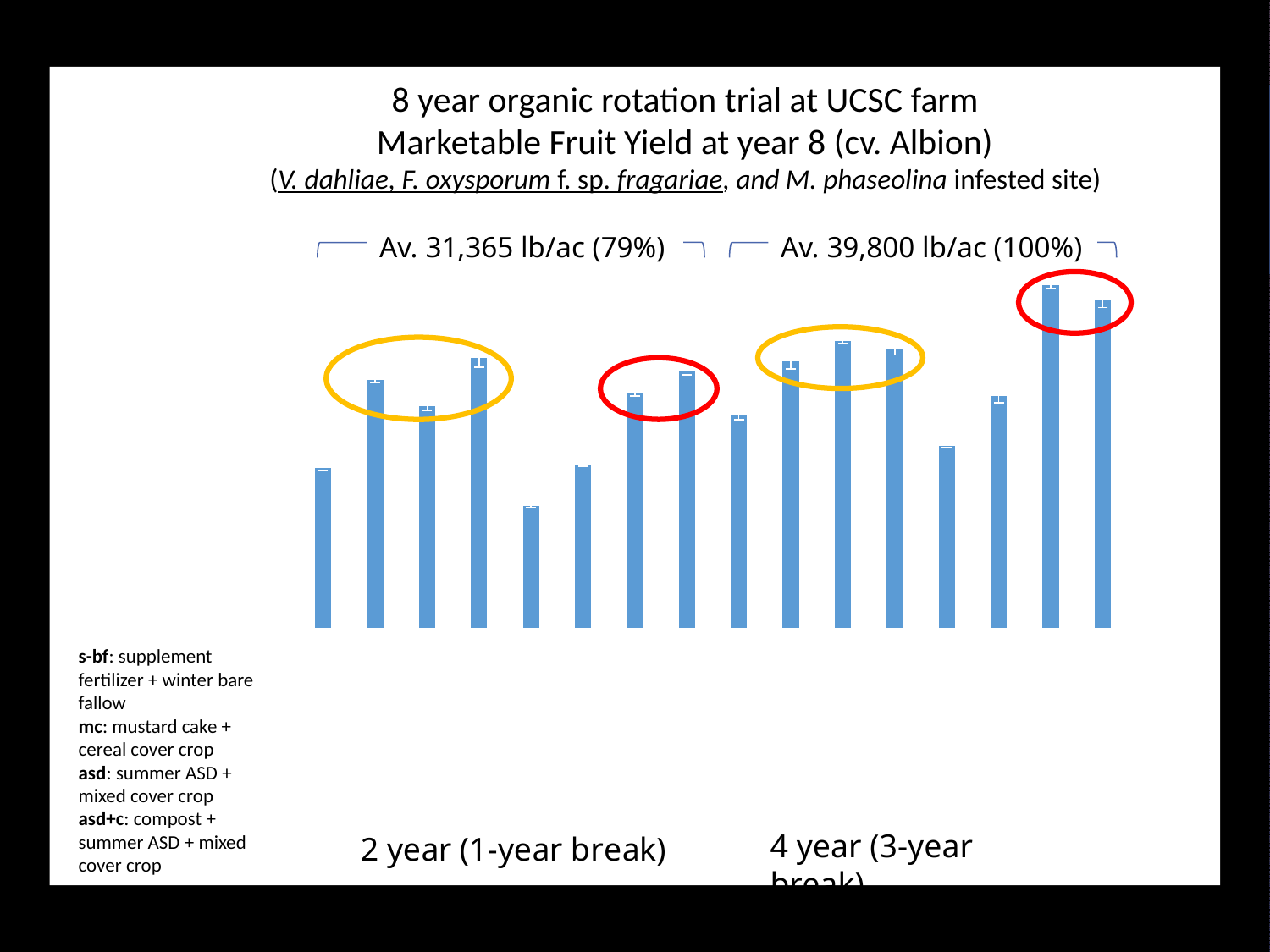
What kind of chart is shown on the slide? bar chart What average yield is annotated above the 2 year (1-year break) group of bars? 31,365 lb/ac Which strawberry cultivar is named in the chart title? Albion At which farm was the 8 year organic rotation trial conducted, according to the title? UCSC farm Which group has the higher annotated average yield, the 2 year (1-year break) group or the 4 year (3-year break) group? 4 year (3-year break) Counting from the left, which bar is the shortest in the chart? 5th What percentage is shown next to the average of 39,800 lb/ac? 100% What average yield is annotated above the 4 year (3-year break) group of bars? 39,800 lb/ac Counting from the left, which bar is the tallest in the chart? 15th How many bars are plotted in the chart? 16 What is the difference between the two annotated average yields, 39,800 lb/ac and 31,365 lb/ac? 8,435 lb/ac What percentage is shown next to the average of 31,365 lb/ac? 79%